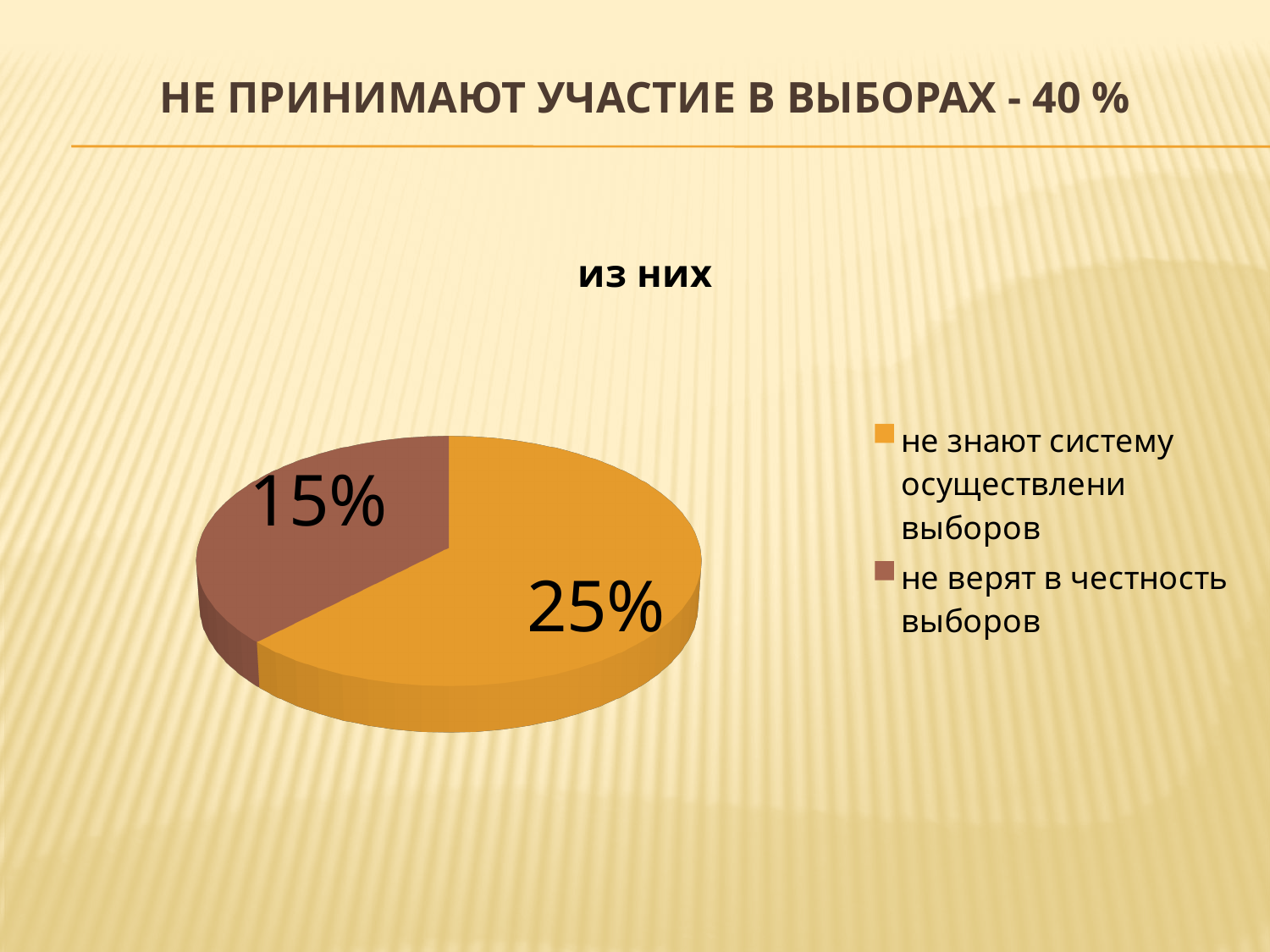
Which category has the largest slice of the pie? не знают систему осуществлени выборов What is the title of the chart? из них What value is shown for the slice "не знают систему осуществлени выборов"? 25% What is the total of the two values shown on the pie chart? 40% What colour is the slice for "не верят в честность выборов"? Brown What value is shown for the slice "не верят в честность выборов"? 15% What kind of chart is shown on the slide? Pie chart How many entries does the legend list? 2 Which is larger: the value for "не знают систему осуществлени выборов" or the value for "не верят в честность выборов"? не знают систему осуществлени выборов How many slices does the pie chart have? 2 Which category has the smallest slice of the pie? не верят в честность выборов What is the difference between the values for "не знают систему осуществлени выборов" and "не верят в честность выборов"? 10%